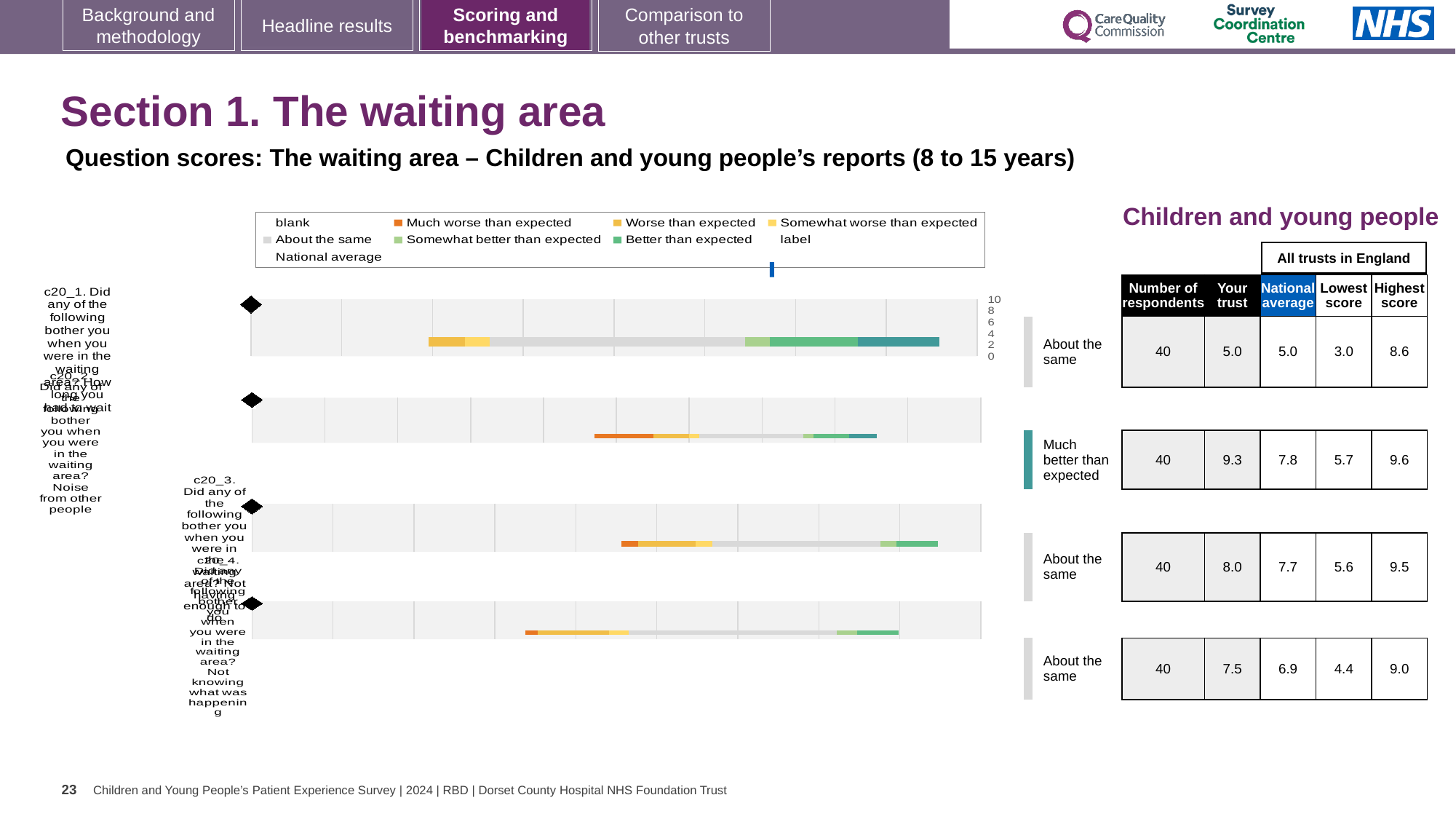
In the table beside the chart, what is the national average for the row labelled 'Much better than expected'? 7.8 In the table beside the chart, is the 'Your trust' score for the last row (7.5) larger or smaller than its national average (6.9)? larger In the table beside the chart, which row has the highest 'Your trust' score? Much better than expected (9.3) In the table beside the chart, what is the difference between the 'Your trust' score and the national average for the 'Much better than expected' row? 1.5 In the table beside the chart, what is the lowest 'Your trust' score shown? 5.0 In the table beside the chart, how many respondents are shown for each question? 40 In the table beside the chart, what is the 'Your trust' score for the row labelled 'Much better than expected'? 9.3 What is the first legend entry listed after 'About the same' in the chart legend? Somewhat better than expected Which colour does the chart legend use for 'Much worse than expected'? orange How many question bars are plotted in the chart? 4 What kind of chart is shown on the slide? bar chart In the table beside the chart, what is the highest score across all trusts in England for the first row? 8.6